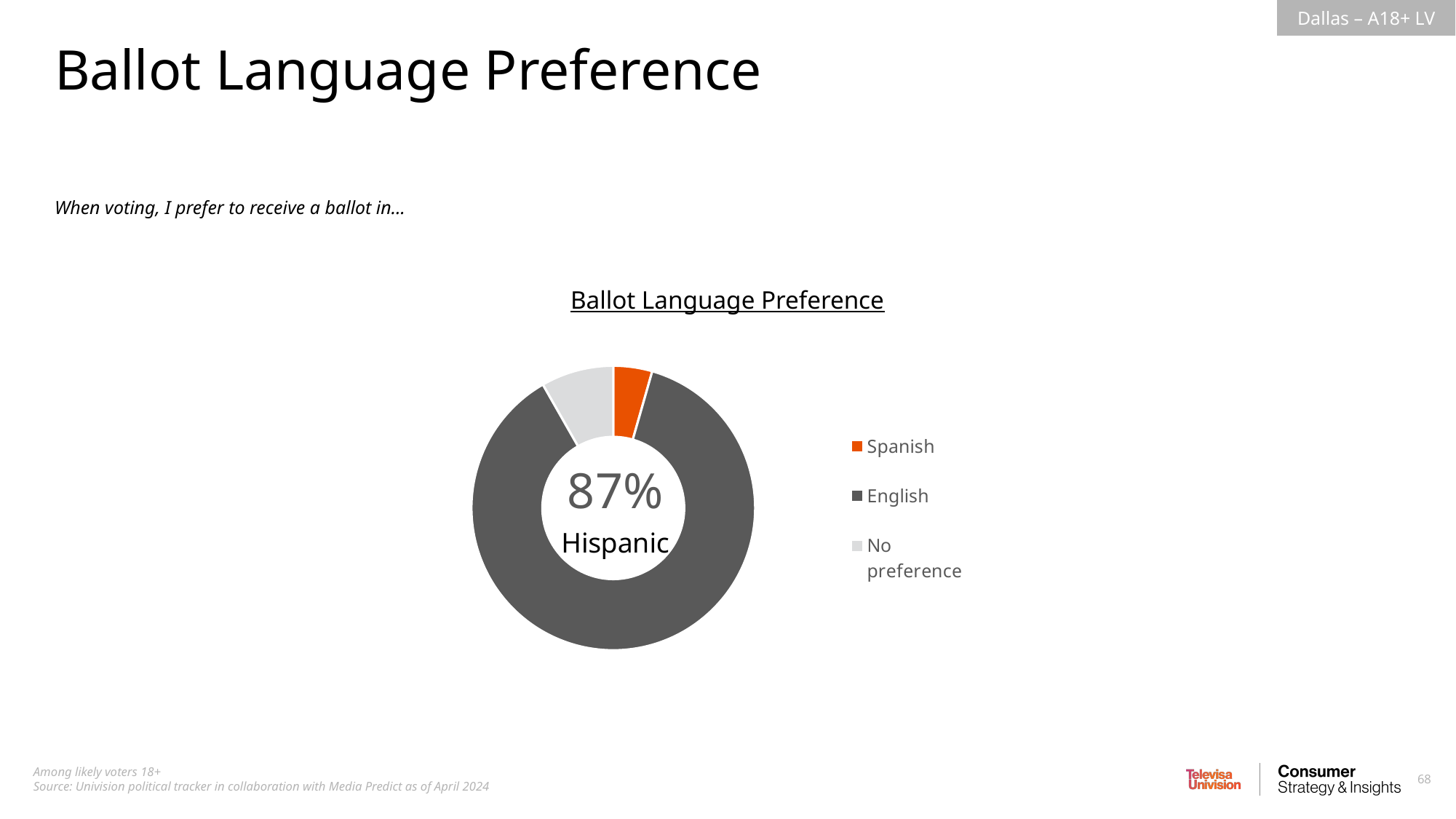
Which category does the 87% shown in the centre of the donut correspond to? English What percentage is printed in the centre of the donut chart? 87% Which slice is larger, No preference or Spanish? No preference What colour represents Spanish in the chart? orange What kind of chart is shown on the slide? donut (pie) chart How many categories does the Ballot Language Preference chart show? 3 How many entries does the legend of the chart list? 3 Which ballot language category has the smallest slice of the donut? Spanish Which ballot language category has the largest slice of the donut? English What is the title of the chart? Ballot Language Preference Which slice is larger, English or Spanish? English